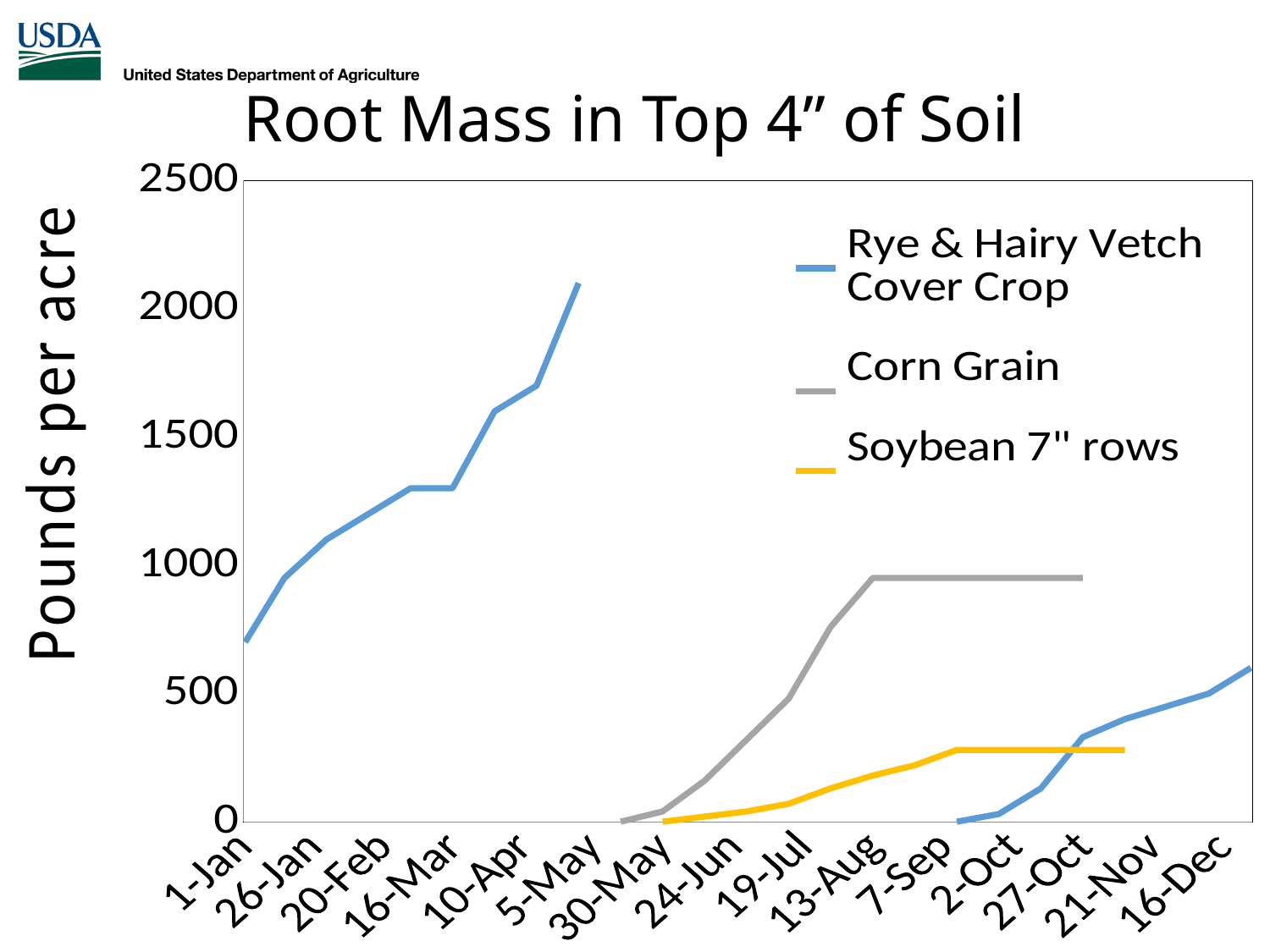
Is the peak value for Soybean 7" rows greater or less than 500? less Which series has the lowest peak value? Soybean 7" rows What is the label on the vertical axis? Pounds per acre Which series reaches the highest value on the chart? Rye & Hairy Vetch Cover Crop Which has a higher peak value, Corn Grain or Soybean 7" rows? Corn Grain What is the title of the chart? Root Mass in Top 4" of Soil Is the peak value for Corn Grain greater or less than 1000? less Is the value for Rye & Hairy Vetch Cover Crop at 1-Jan greater or less than 500? greater How many series does the legend list? 3 Does the Rye & Hairy Vetch Cover Crop line rise or fall from 1-Jan to 5-May? rise What kind of chart is shown on the slide? Line chart